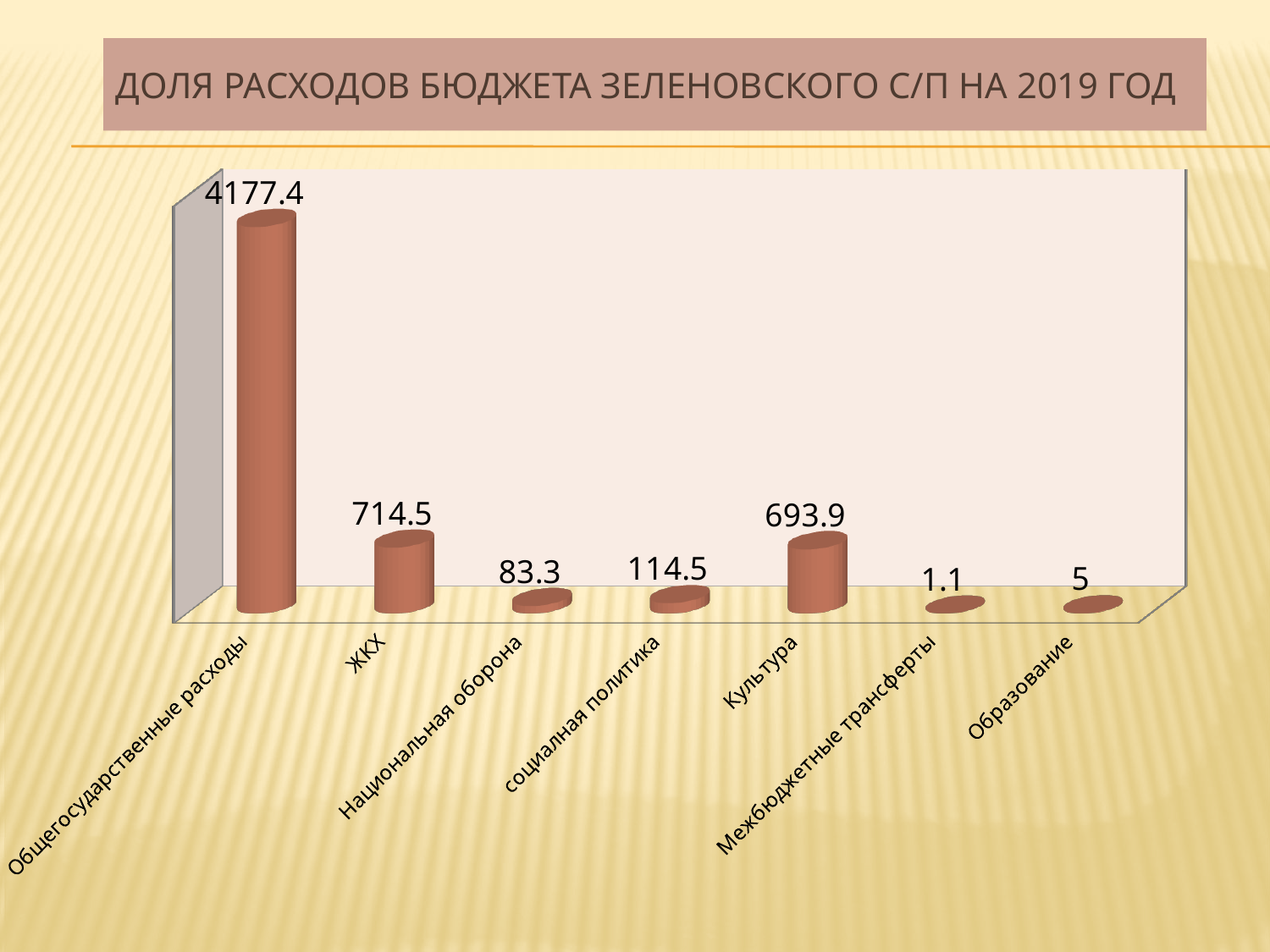
Which is larger, the value for ЖКХ or the value for Культура? ЖКХ What kind of chart is shown on the slide? Bar chart Which category has the highest value? Общегосударственные расходы What is the difference between the values for ЖКХ and Культура? 20.6 What is the value for Межбюджетные трансферты? 1.1 What is the value for Культура? 693.9 What is the value for ЖКХ? 714.5 What is the value for Общегосударственные расходы? 4177.4 What is the value for Образование? 5 How many categories are shown in the chart? 7 What is the difference between the values for социальная политика and Национальная оборона? 31.2 Which category has the lowest value? Межбюджетные трансферты